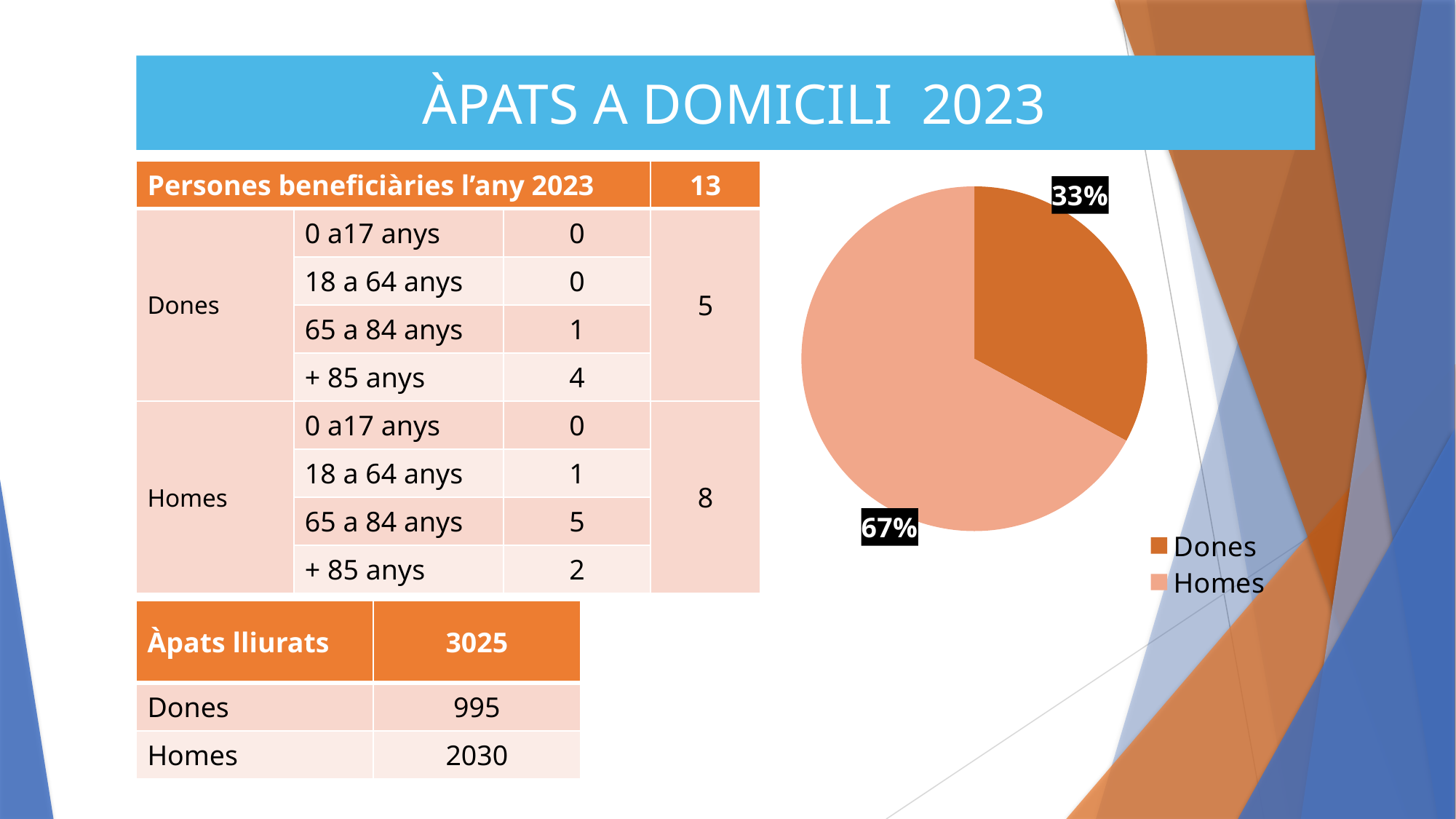
What share of the pie chart does Homes represent? 67% Which slice of the pie chart is the smallest? Dones Which slice of the pie chart is the largest? Homes What kind of chart is shown on the slide? pie chart Which slice of the pie chart is shown in the darker orange colour? Dones How many entries does the pie chart legend list? 2 In the pie chart, which is larger, Dones or Homes? Homes What share of the pie chart does Dones represent? 33% How many slices does the pie chart have? 2 What is the difference in percentage points between the Homes and Dones slices of the pie chart? 34 Which categories are listed in the pie chart legend? Dones, Homes